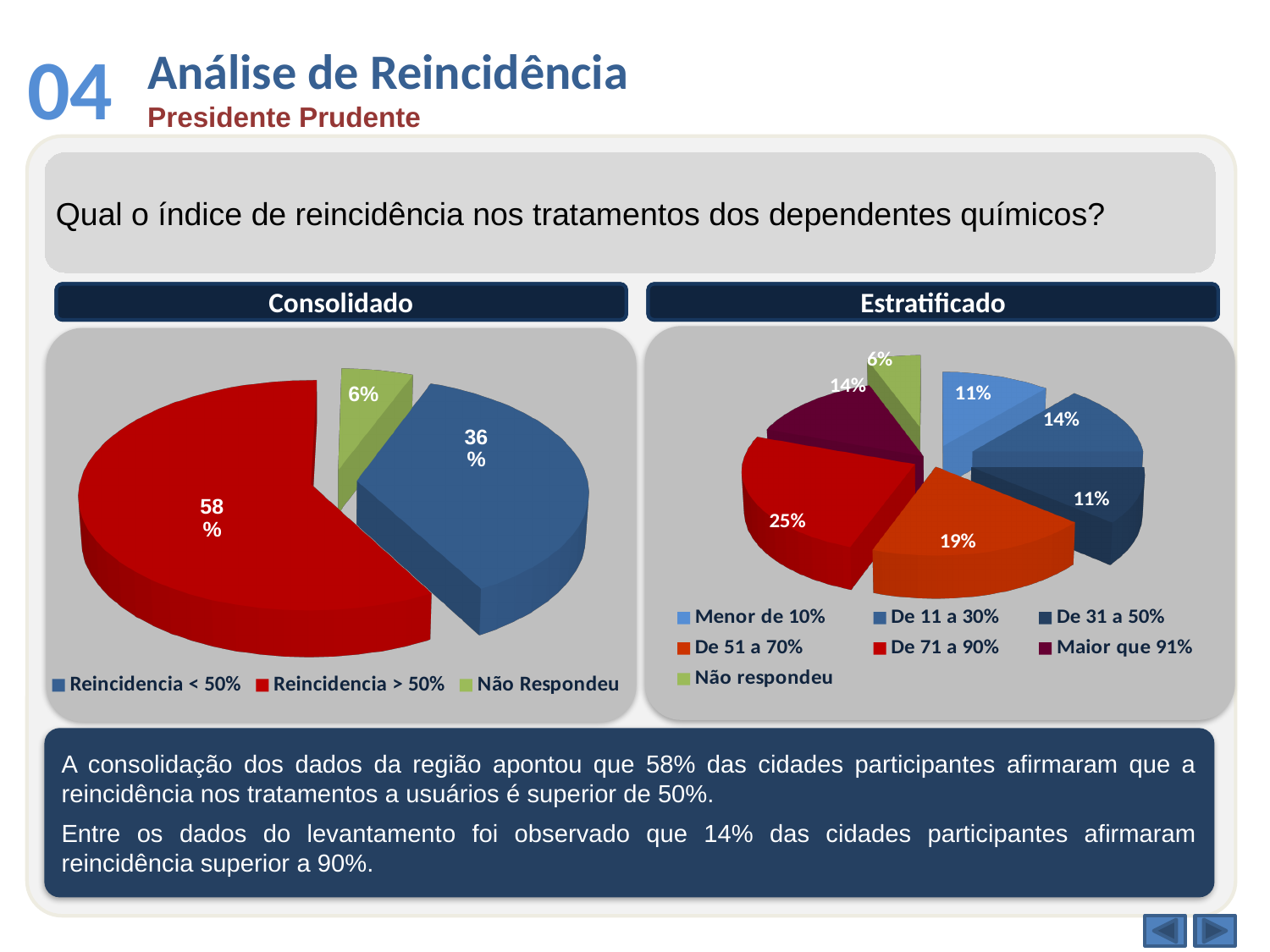
In the Estratificado chart, what percentage is shown for Não respondeu? 6% How many categories does the legend of the Consolidado chart list? 3 In the Estratificado chart, what percentage is shown for De 51 a 70%? 19% In the Estratificado chart, which category has the largest slice? De 71 a 90% In the Consolidado chart, what is the difference between Reincidencia > 50% and Reincidencia < 50%? 22% In the Consolidado chart, what percentage is shown for Reincidencia < 50%? 36% In the Estratificado chart, what percentage is shown for De 71 a 90%? 25% In the Estratificado chart, which is larger: De 11 a 30% or De 31 a 50%? De 11 a 30% How many categories does the legend of the Estratificado chart list? 7 In the Consolidado chart, which category has the smallest slice? Não Respondeu In the Consolidado chart, what percentage is shown for Reincidencia > 50%? 58% What kind of chart is the Consolidado chart? Pie chart